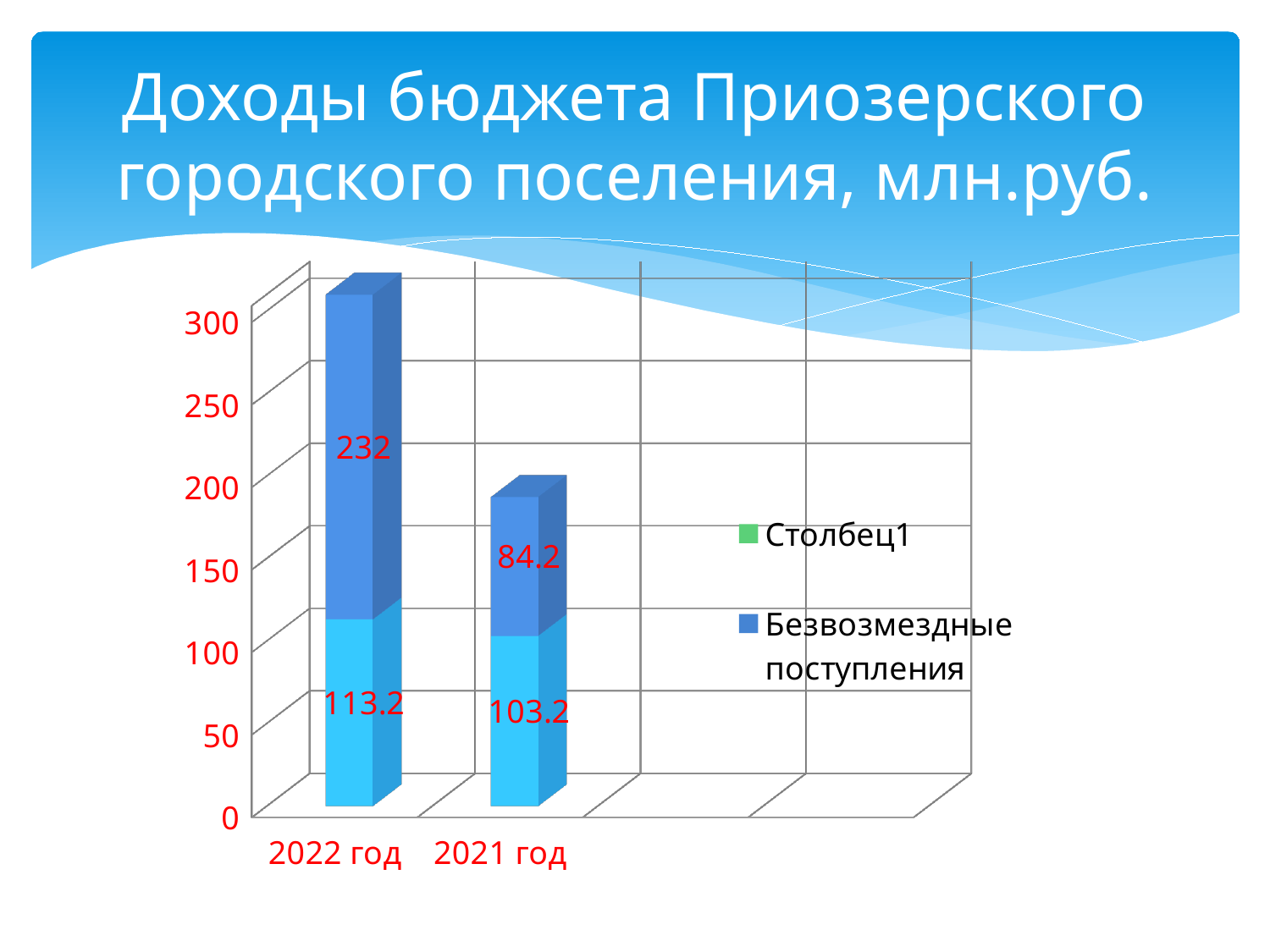
How many categories are shown on the x axis? 2 What is the value of Безвозмездные поступления for 2021 год? 84.2 What is the total of the stacked bar for 2021 год? 187.4 What is the difference between Безвозмездные поступления in 2022 год and 2021 год? 147.8 How many series does the legend list? 2 What value is printed on the bottom (light blue) segment of the 2021 год bar? 103.2 What kind of chart is shown on the slide? Stacked bar chart What is the value of Безвозмездные поступления for 2022 год? 232 Is the bottom segment of the 2022 год bar larger or smaller than the bottom segment of the 2021 год bar? larger What value is printed on the bottom (light blue) segment of the 2022 год bar? 113.2 Which year has the higher value of Безвозмездные поступления? 2022 год What is the total of the stacked bar for 2022 год? 345.2